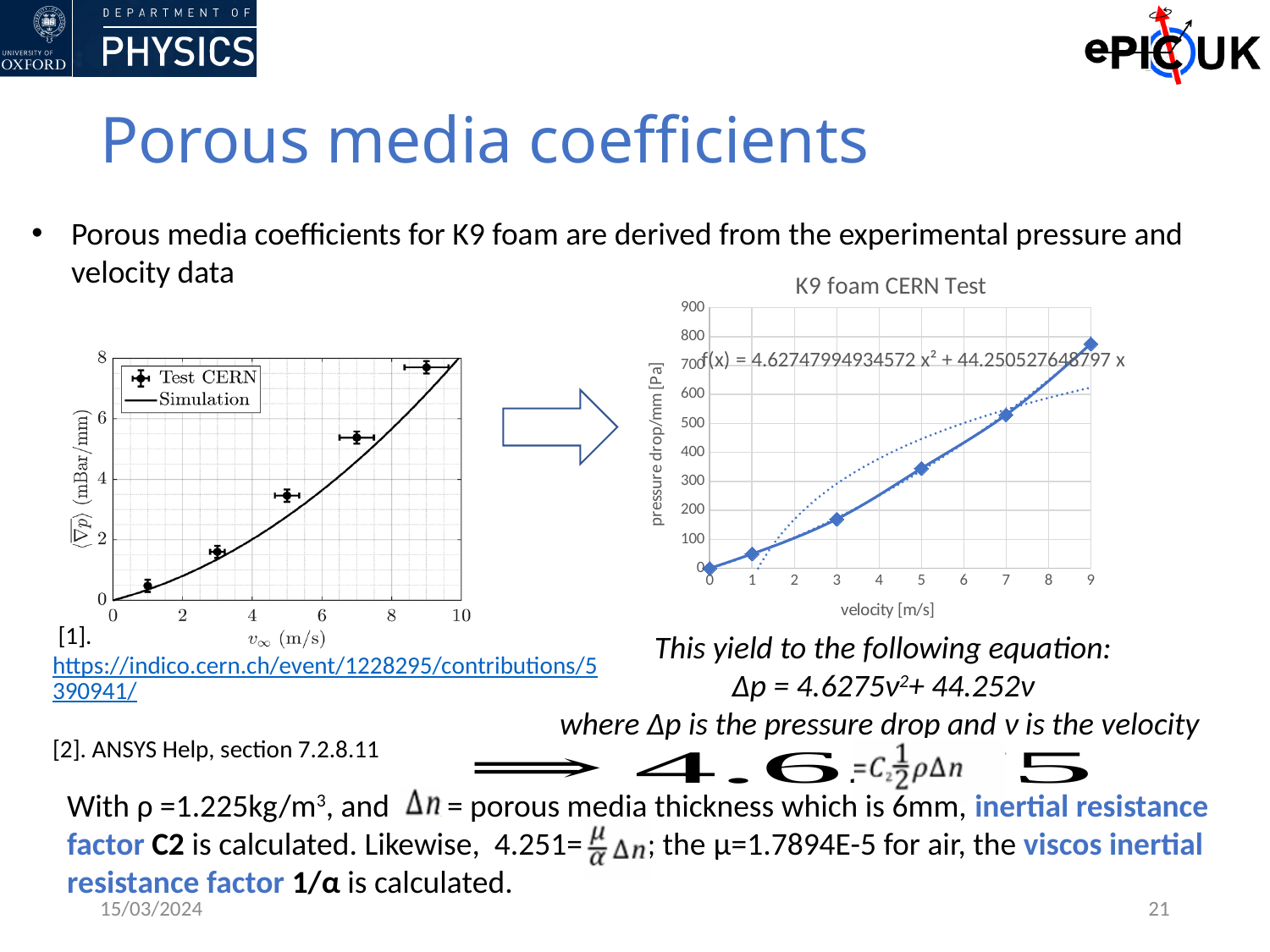
In the 'K9 foam CERN Test' chart, how many data points are plotted? 6 In the 'K9 foam CERN Test' chart, is the pressure drop at a velocity of 3 m/s greater or less than 100? greater What kind of chart is the 'K9 foam CERN Test' chart on the right of the slide? scatter chart In the 'K9 foam CERN Test' chart, which has the larger pressure drop: velocity 7 m/s or velocity 5 m/s? 7 m/s What trendline equation is displayed on the 'K9 foam CERN Test' chart? f(x) = 4.62747994934572 x² + 44.250527648797 x What is the label of the vertical axis in the 'K9 foam CERN Test' chart? pressure drop/mm [Pa] In the 'K9 foam CERN Test' chart, does the pressure drop rise or fall as velocity increases? rise In the 'K9 foam CERN Test' chart, is the pressure drop at a velocity of 9 m/s greater or less than 700? greater In the chart on the left of the slide, how many 'Test CERN' data points are plotted? 5 In the chart on the left of the slide, does the pressure gradient rise or fall as velocity increases? rise In the 'K9 foam CERN Test' chart, at which velocity is the pressure drop highest? 9 In the 'K9 foam CERN Test' chart, is the pressure drop at a velocity of 5 m/s greater or less than 400? less